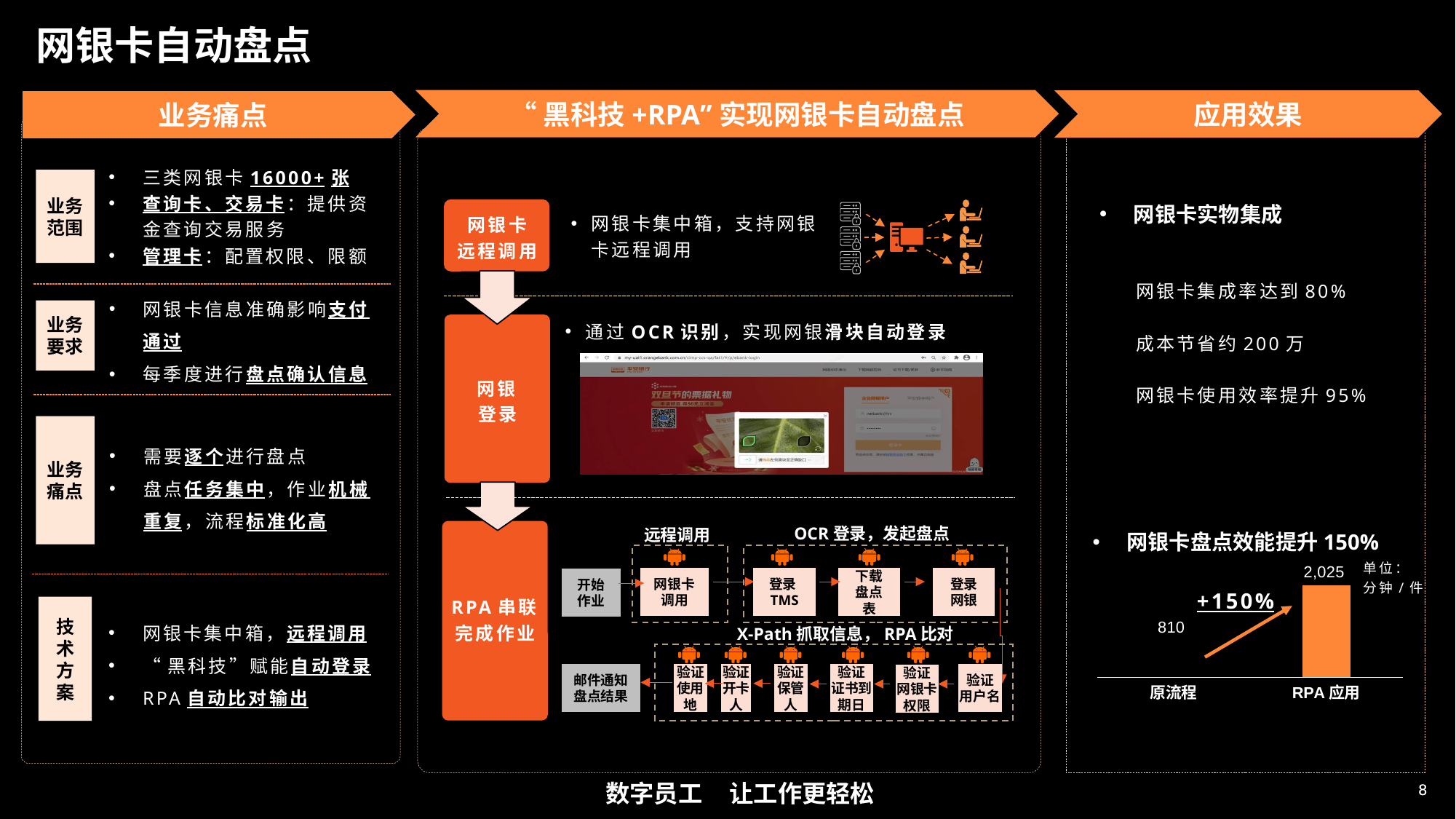
In the bar chart at the bottom right of the slide, is the value for RPA 应用 larger or smaller than the value for 原流程? larger In the bar chart at the bottom right of the slide, which category has the higher value? RPA 应用 What unit is stated for the values in the bar chart at the bottom right of the slide? 分钟 / 件 In the bar chart at the bottom right of the slide, what is the value for 原流程? 810 In the bar chart at the bottom right of the slide, what is the value for RPA 应用? 2,025 How many categories are shown on the x axis of the bar chart at the bottom right of the slide? 2 What percentage change is annotated on the arrow in the bar chart at the bottom right of the slide? +150% What kind of chart is shown at the bottom right of the slide? bar chart In the bar chart at the bottom right of the slide, which category has the lower value? 原流程 In the bar chart at the bottom right of the slide, do the values rise or fall from 原流程 to RPA 应用? rise In the bar chart at the bottom right of the slide, what is the difference between the RPA 应用 value and the 原流程 value? 1,215